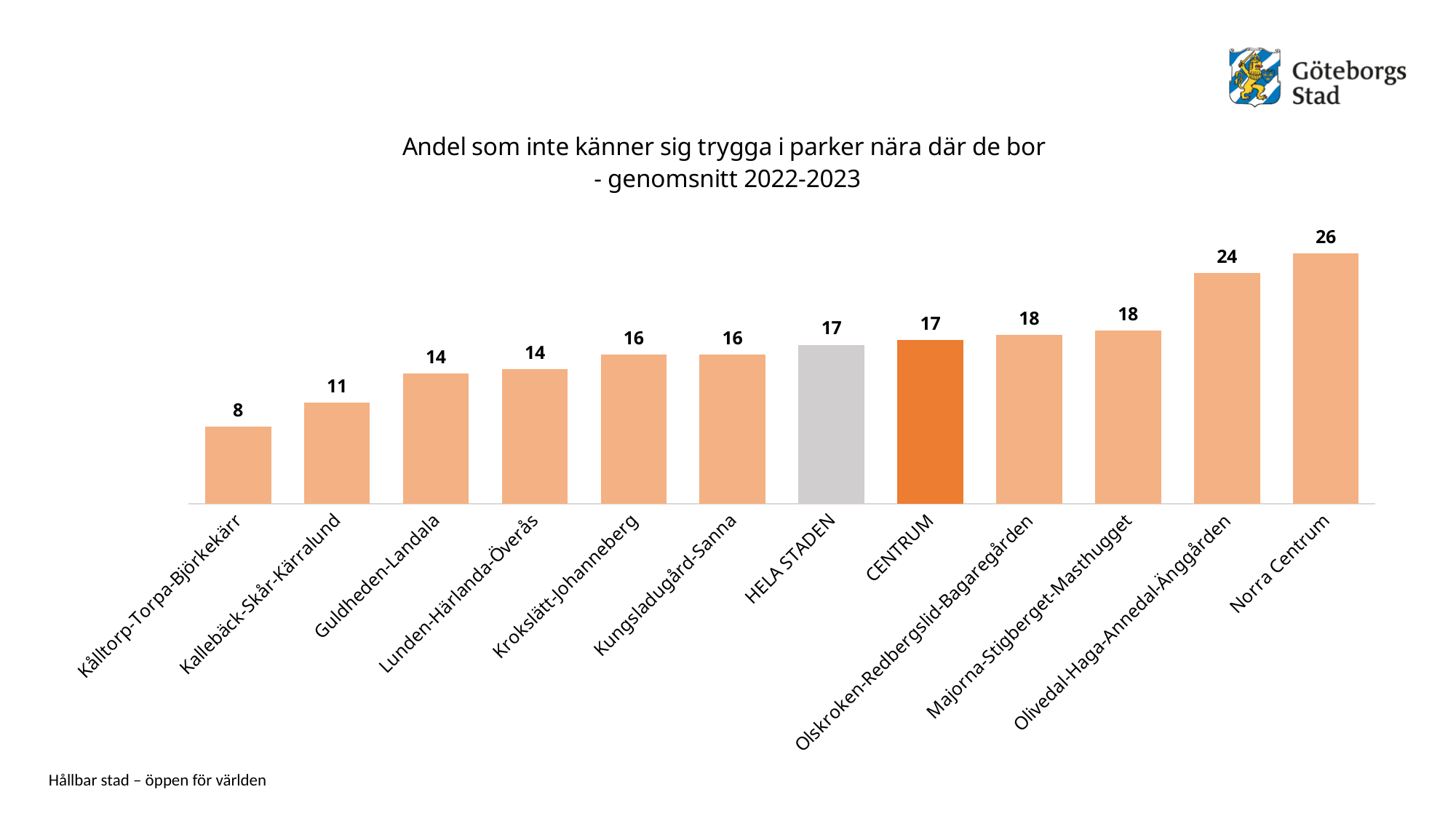
Which bar is coloured dark orange? CENTRUM What is the value for HELA STADEN? 17 What is the value for Kålltorp-Torpa-Björkekärr? 8 What is the difference between the values for Norra Centrum and Kålltorp-Torpa-Björkekärr? 18 What is the difference between the values for CENTRUM and Kallebäck-Skår-Kärralund? 6 What kind of chart is shown on the slide? Bar chart What is the value for Norra Centrum? 26 What is the value for Olivedal-Haga-Annedal-Änggården? 24 Which is larger, the value for Majorna-Stigberget-Masthugget or the value for Guldheden-Landala? Majorna-Stigberget-Masthugget Which category has the highest value? Norra Centrum How many categories are shown on the chart? 12 Which category has the lowest value? Kålltorp-Torpa-Björkekärr